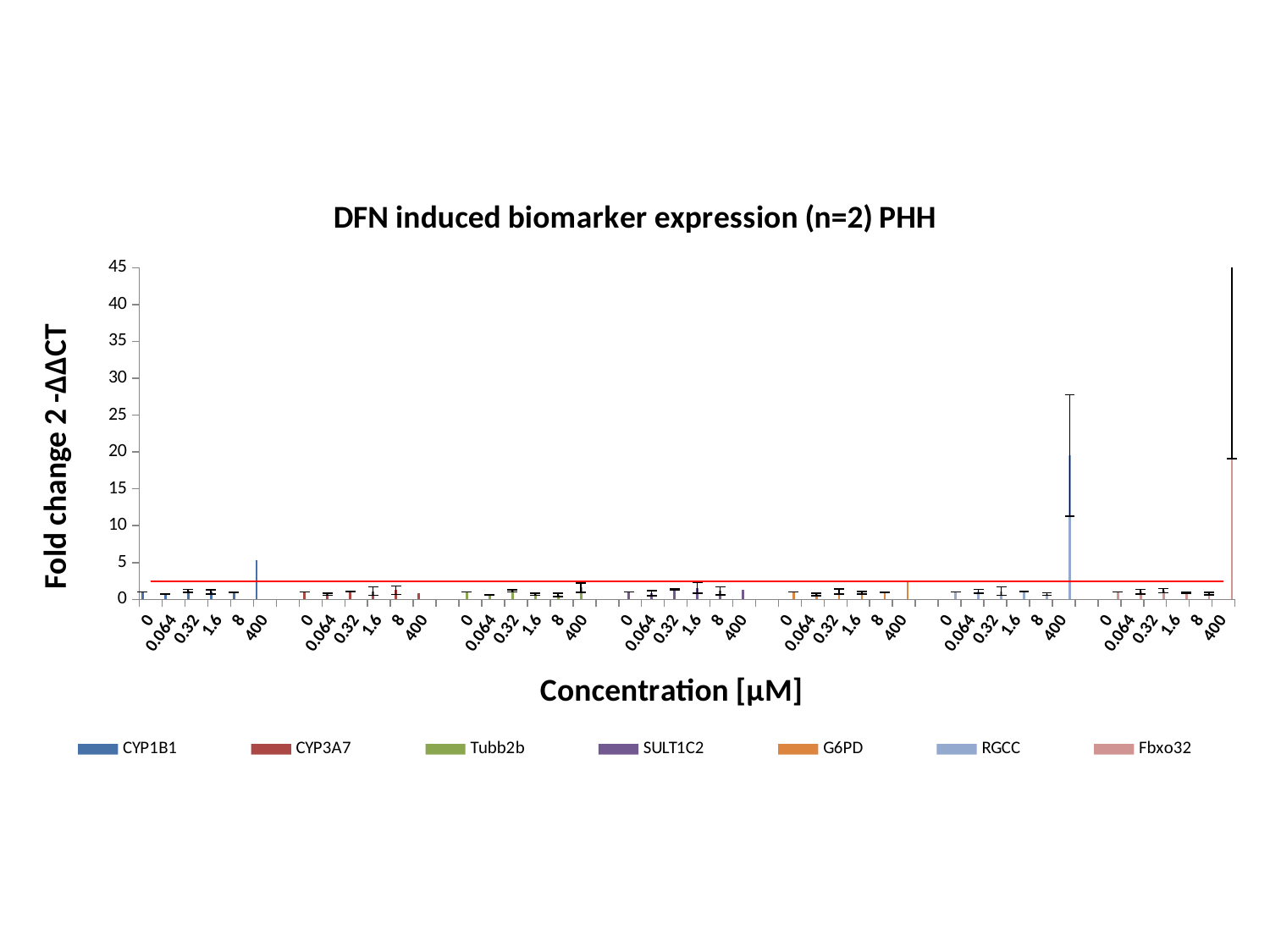
What kind of chart is shown on the slide? bar chart What is the title of the chart? DFN induced biomarker expression (n=2) PHH Is the value for CYP1B1 at 400 µM greater or less than 10? less Within the CYP1B1 series, which concentration has the highest value? 400 How many series does the legend list? 7 Which is larger, the value for RGCC at 400 µM or the value for CYP1B1 at 400 µM? RGCC at 400 µM What is the label of the x axis? Concentration [µM] Is the value for Fbxo32 at 400 µM greater or less than 10? greater Is the value for G6PD at 400 µM greater or less than 5? less Which is larger, the value for CYP1B1 at 400 µM or the value for CYP3A7 at 400 µM? CYP1B1 at 400 µM How many concentration levels are plotted for each series? 6